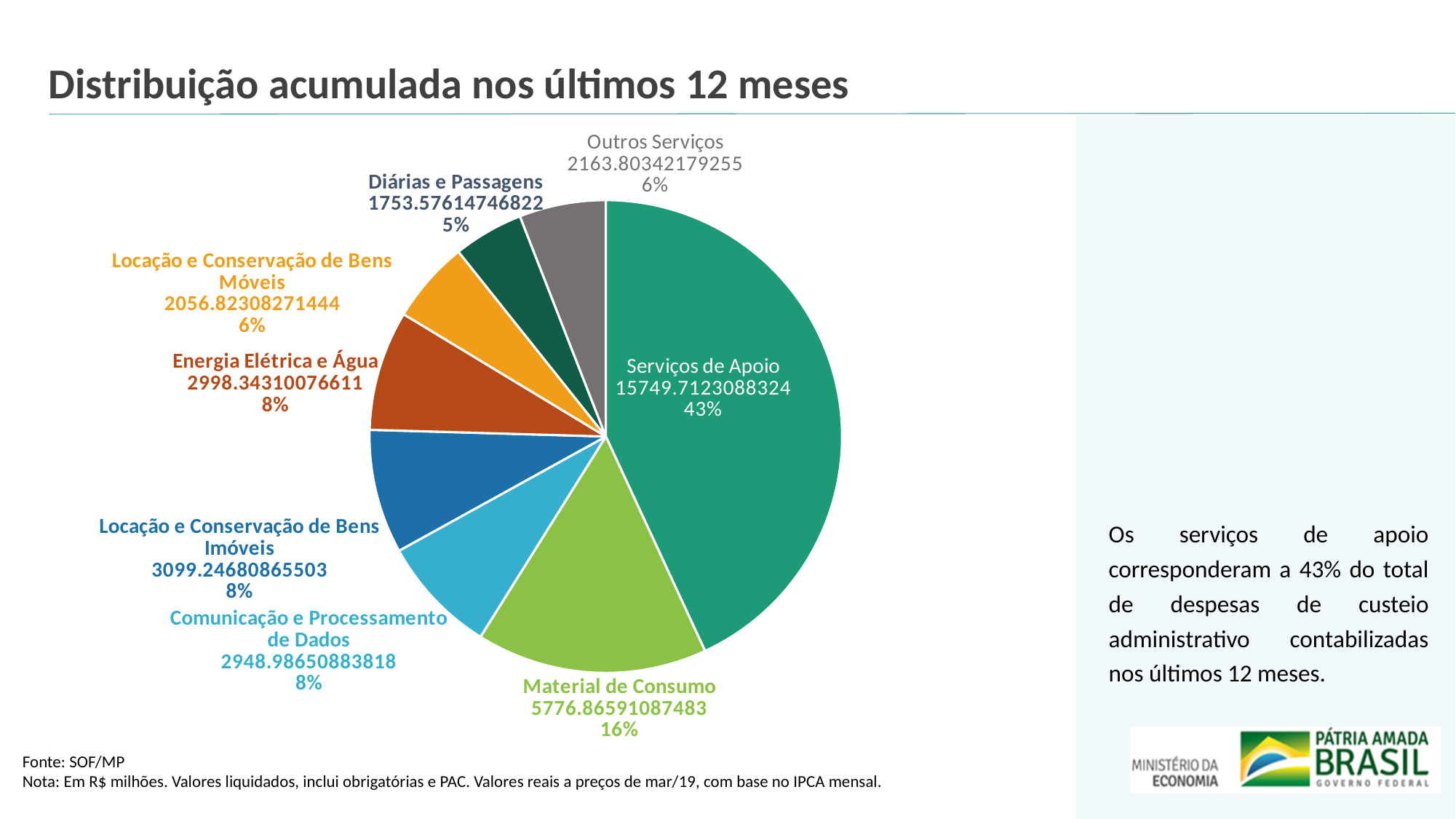
Which category has the smallest slice of the pie? Diárias e Passagens What is the value shown for Material de Consumo? 5776.86591087483 Which category has the largest slice of the pie? Serviços de Apoio What is the value shown for Diárias e Passagens? 1753.57614746822 By how many percentage points does the share of Serviços de Apoio exceed the share of Material de Consumo? 27 percentage points Which is larger: the value for Locação e Conservação de Bens Imóveis or the value for Energia Elétrica e Água? Locação e Conservação de Bens Imóveis What share of the pie does Material de Consumo represent? 16% How many slices does the pie chart have? 8 What is the value shown for Serviços de Apoio? 15749.7123088324 What share of the pie does Serviços de Apoio represent? 43% What kind of chart is shown on the slide? pie chart What is the title of the chart on the slide? Distribuição acumulada nos últimos 12 meses